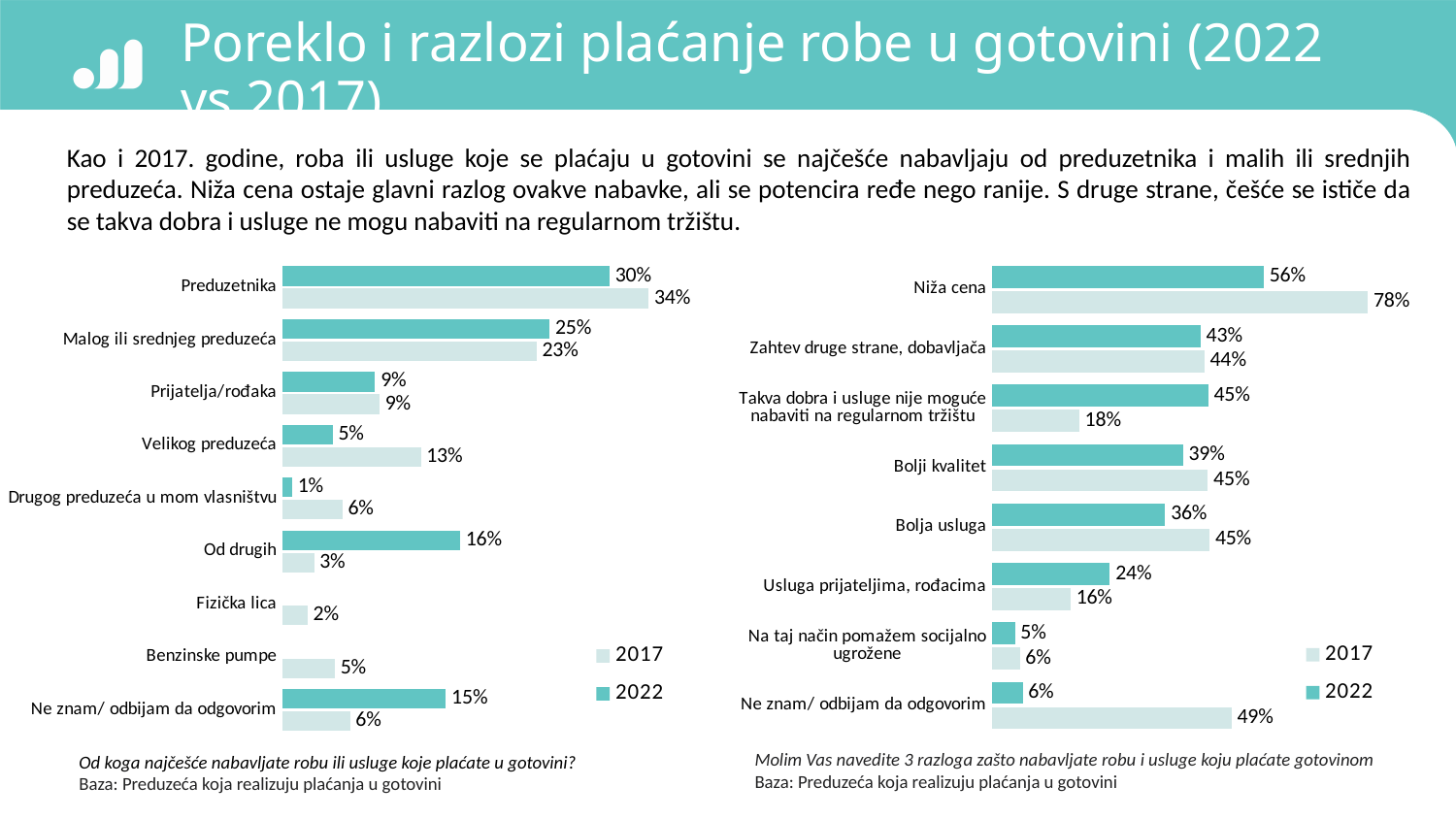
On the right chart, is the 2022 value for Bolja usluga larger or smaller than its 2017 value? smaller On the right chart, what is the difference between the 2017 and 2022 values for Ne znam/ odbijam da odgovorim? 43% On the left chart, what is the 2022 value for Preduzetnika? 30% On the right chart, what is the 2022 value for Takva dobra i usluge nije moguće nabaviti na regularnom tržištu? 45% How many series does the legend of the left chart list? 2 On the left chart, which category has the lowest 2022 value among those with a 2022 bar? Drugog preduzeća u mom vlasništvu On the left chart, what is the 2017 value for Velikog preduzeća? 13% How many categories are shown on the right chart? 8 On the right chart, which category has the highest 2022 value? Niža cena On the right chart, what is the 2017 value for Niža cena? 78% On the left chart, what is the difference between the 2022 and 2017 values for Od drugih? 13% What type of chart is the left chart? bar chart